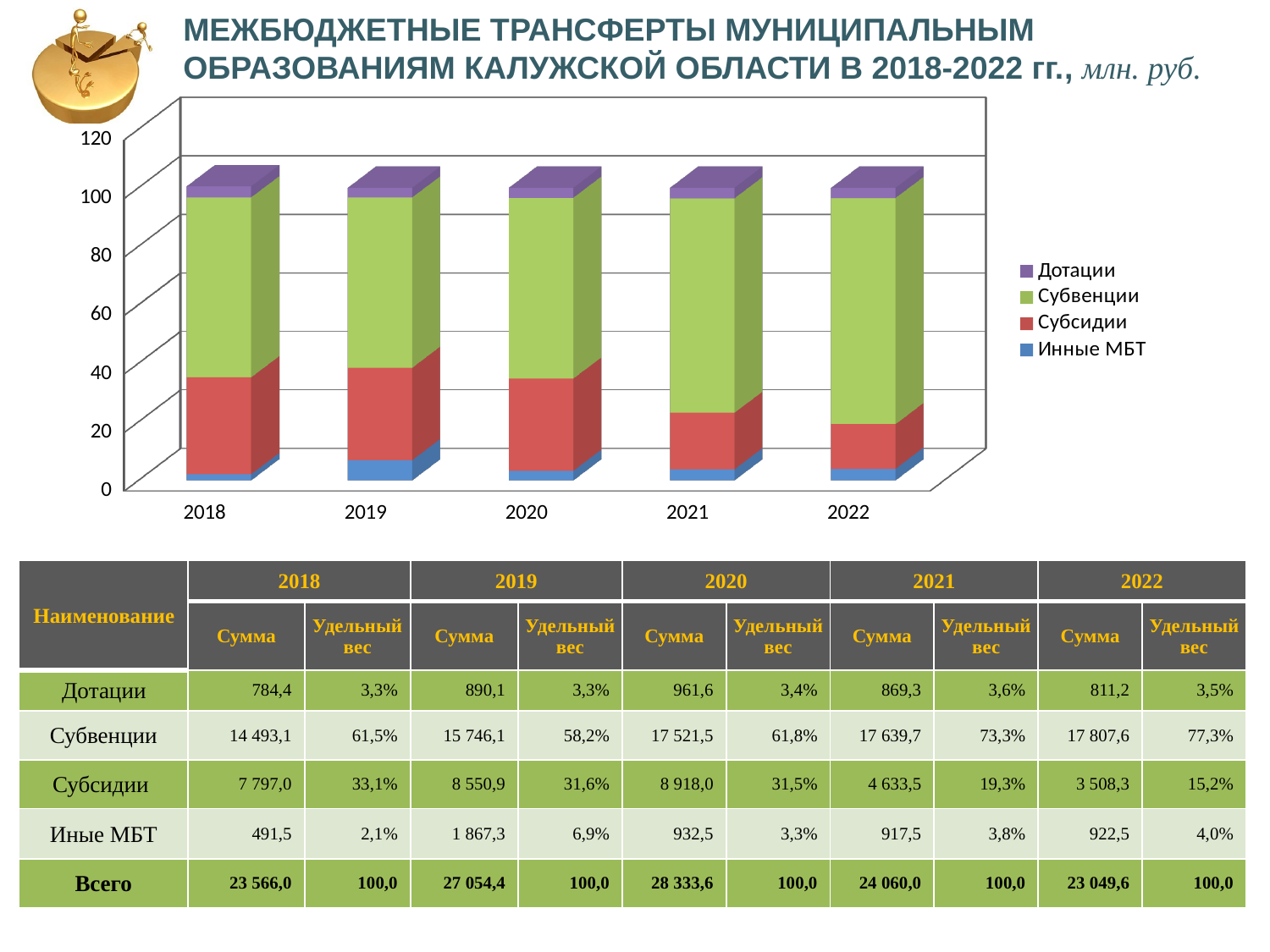
How many series does the chart legend list? 4 What kind of chart is shown on the slide? Stacked bar chart In which year is the share of Субвенции the highest? 2022 In 2019, which is larger: the share of Субвенции or the share of Субсидии? Субвенции Does the share of Субсидии rise or fall from 2018 to 2022? fall Which series has the smallest share in 2018? Иные МБТ Is the Субвенции segment of the 2022 bar greater or less than 60? greater What is the share (удельный вес) of Субвенции in 2021? 73,3% Is the Субсидии segment of the 2018 bar greater or less than 20? greater Which series is shown in green in the chart? Субвенции What is the share (удельный вес) of Субсидии in 2022? 15,2% How many years are shown along the x axis of the chart? 5